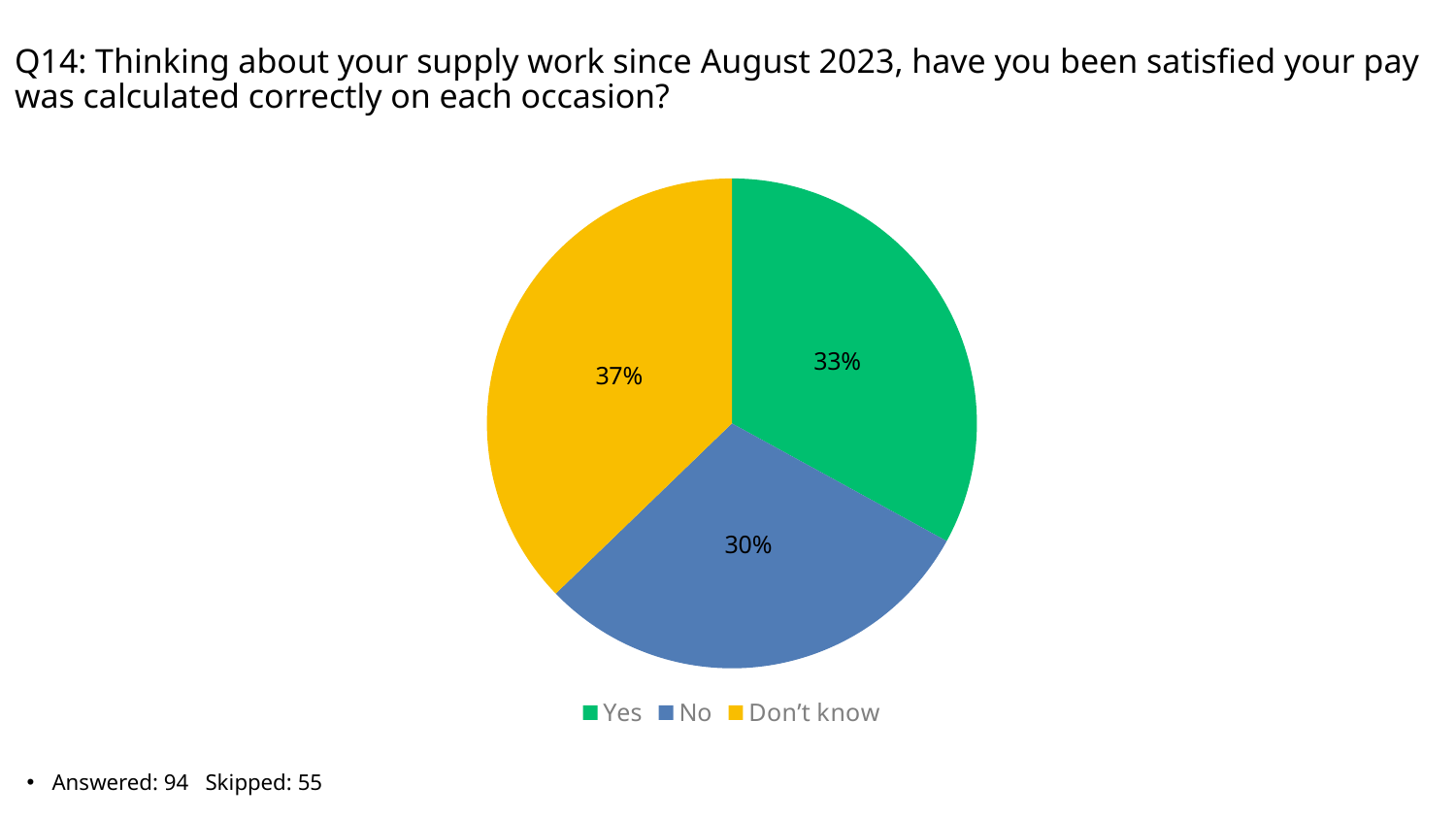
What is the difference in percentage points between the "Don't know" and "No" slices? 7 What kind of chart is shown on the slide? pie chart What percentage of respondents answered "No"? 30% What colour is the "Don't know" slice? yellow Which is larger, the "Yes" slice or the "Don't know" slice? Don't know What percentage of respondents answered "Don't know"? 37% How many slices does the pie chart have? 3 What is the difference in percentage points between the "Yes" and "No" slices? 3 How many entries does the legend list? 3 Which response has the largest share of the pie? Don't know Which response has the smallest share of the pie? No What percentage of respondents answered "Yes"? 33%